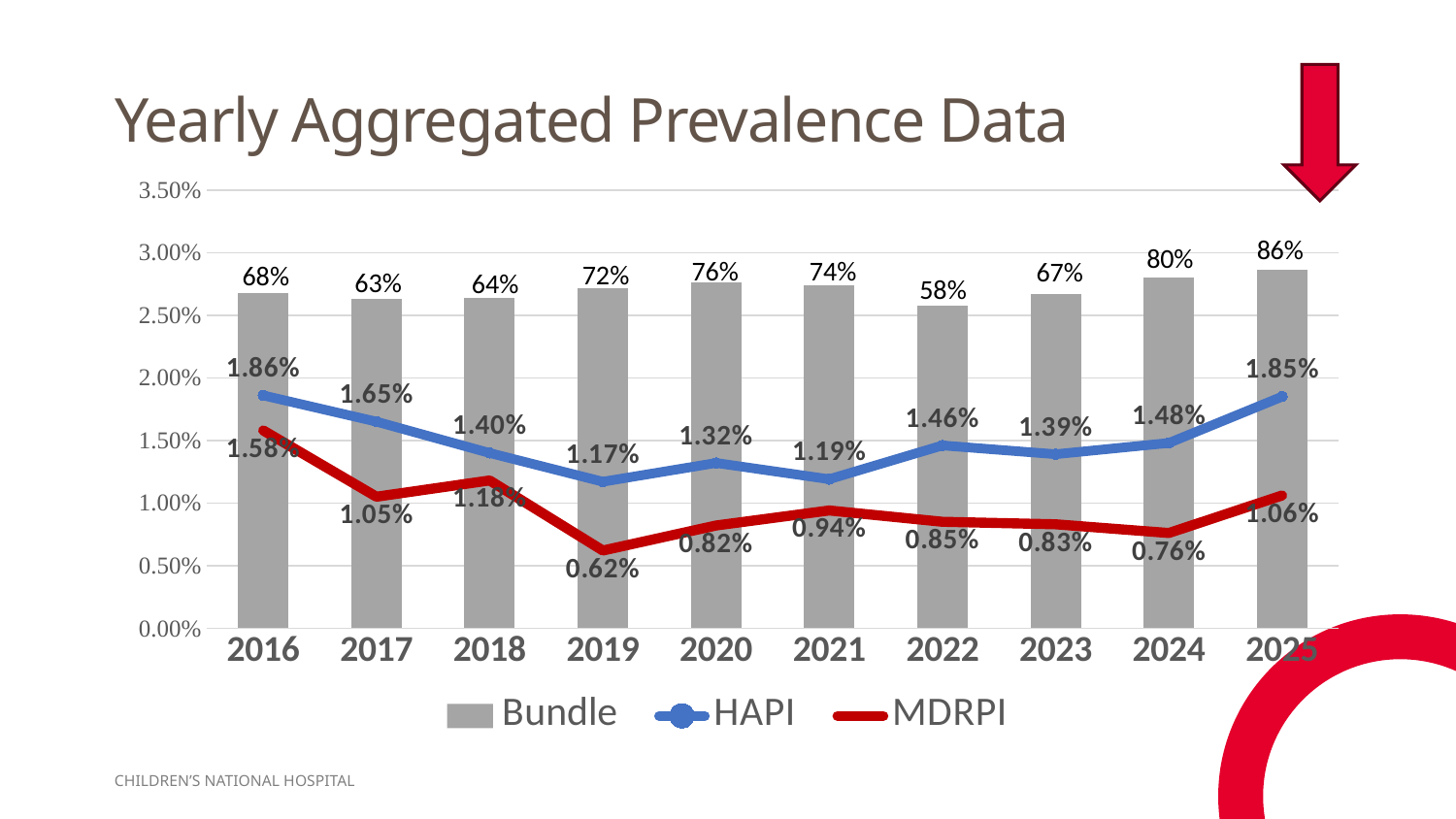
In which year is the MDRPI value lowest? 2019 What kind of chart is this? Combined bar and line chart Which year has the larger HAPI value, 2022 or 2023? 2022 How many years are shown on the x axis? 10 How many series does the legend list? 3 What is the MDRPI value for 2021? 0.94% In which year is the Bundle value highest? 2025 What is the difference between the HAPI value in 2016 and in 2019? 0.69% Is the HAPI value for 2016 greater or less than 1.50%? greater Does the MDRPI value rise or fall from 2016 to 2019? fall What is the Bundle value for 2024? 80% What is the HAPI value for 2019? 1.17%